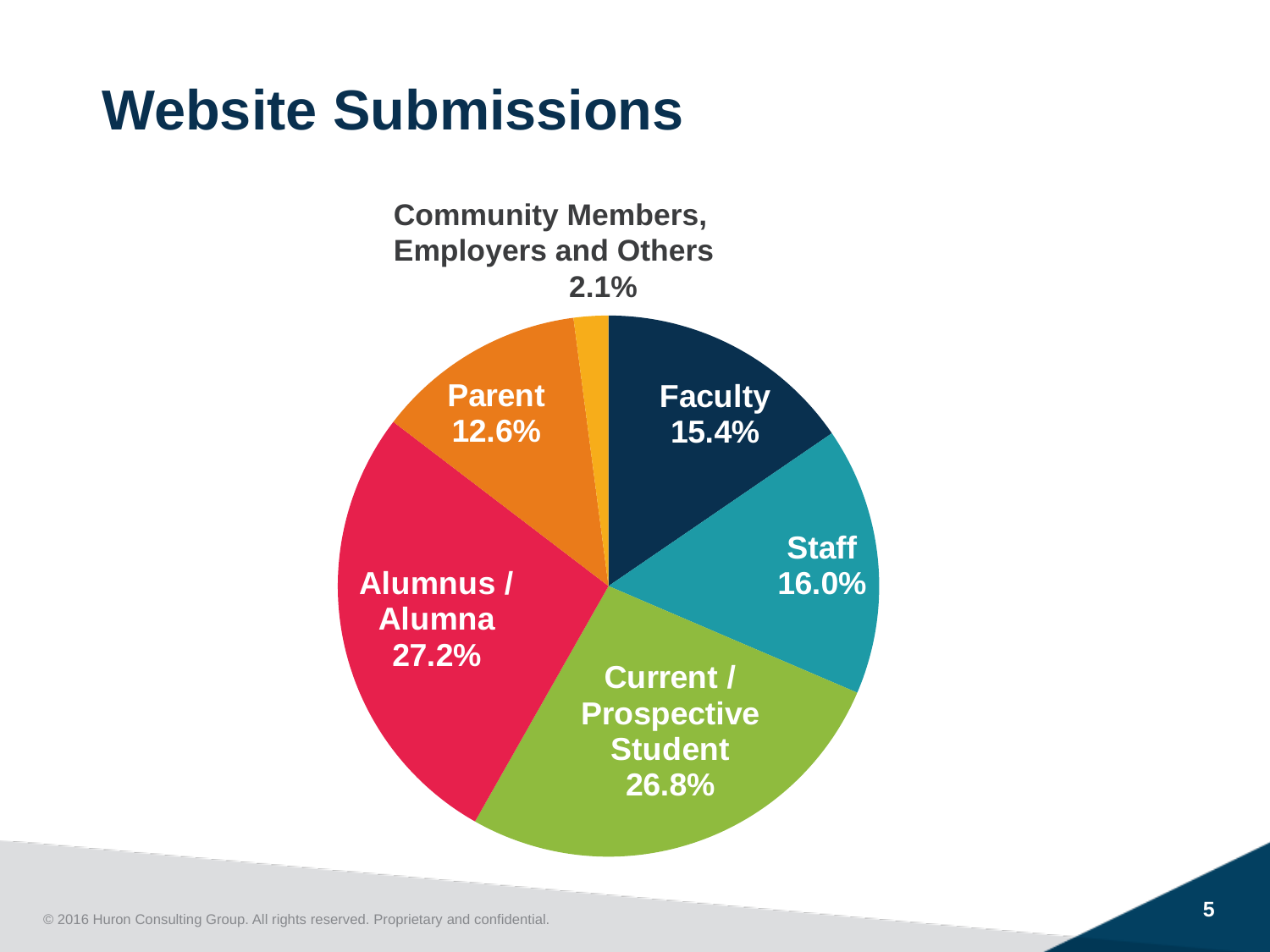
What percentage is shown for Community Members, Employers and Others? 2.1% What is the title of the slide containing the pie chart? Website Submissions What is the difference in percentage points between the Alumnus / Alumna share and the Current / Prospective Student share? 0.4 percentage points What percentage of website submissions came from Staff? 16.0% How many slices does the pie chart have? 6 Which category has the largest share of website submissions? Alumnus / Alumna What percentage of website submissions came from Faculty? 15.4% What share of the pie is labelled Parent? 12.6% Which is larger, the Staff share or the Faculty share? Staff What is the difference in percentage points between the Parent share and the Community Members, Employers and Others share? 10.5 percentage points What type of chart is shown on the slide? Pie chart Which category has the smallest share of website submissions? Community Members, Employers and Others